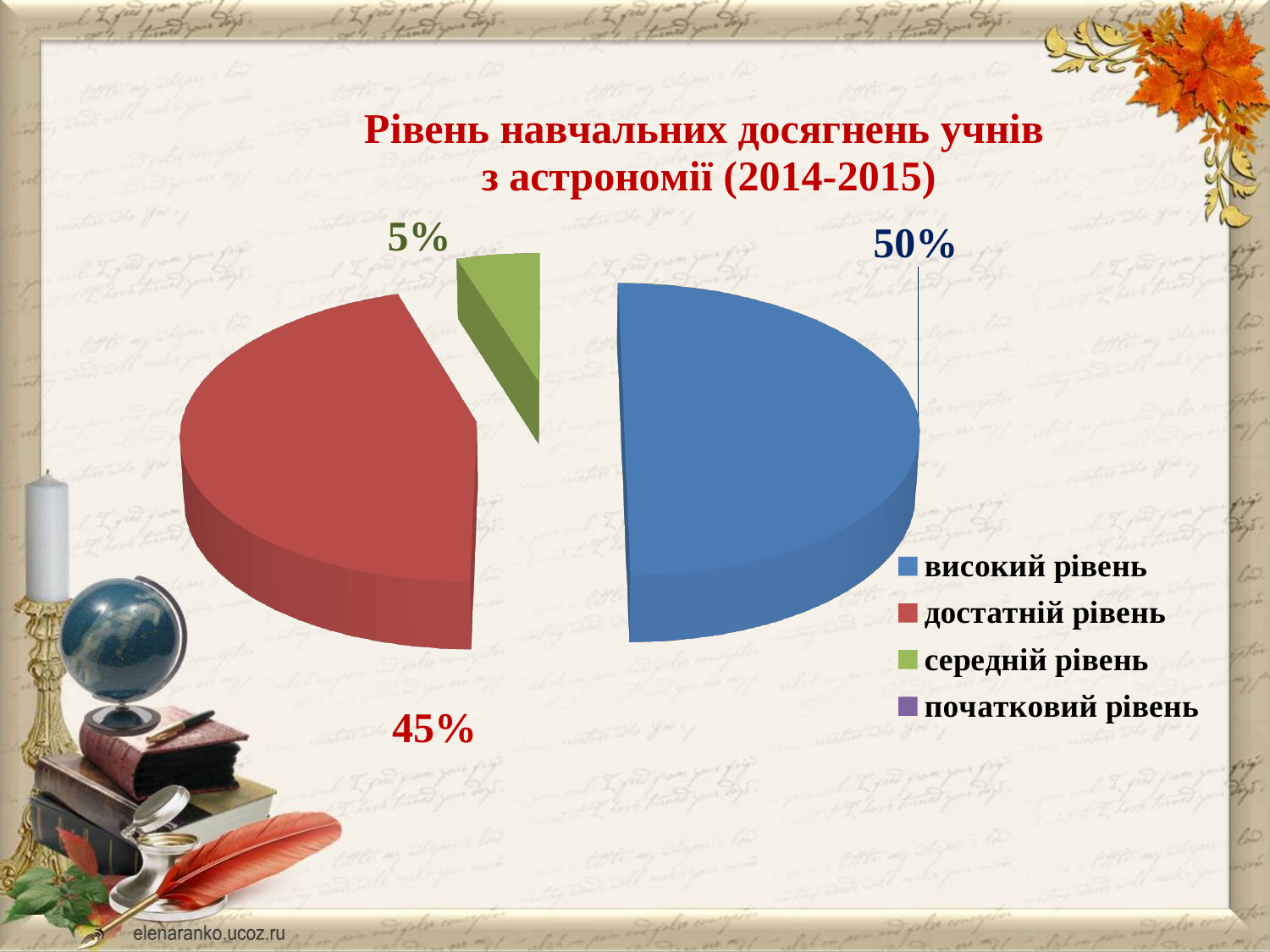
How many entries does the legend list? 4 What share of the pie does "високий рівень" have? 50% Which category has the largest slice of the pie? високий рівень What is the difference between the shares of "високий рівень" and "достатній рівень"? 5% What share of the pie does "середній рівень" have? 5% What share of the pie does "достатній рівень" have? 45% What kind of chart is shown on the slide? pie chart What is the difference between the shares of "достатній рівень" and "середній рівень"? 40% Which is larger, the slice for "достатній рівень" or the slice for "середній рівень"? достатній рівень Which of the visible slices is the smallest? середній рівень What is the title of the chart? Рівень навчальних досягнень учнів з астрономії (2014-2015) What colour is the slice for "достатній рівень"? red